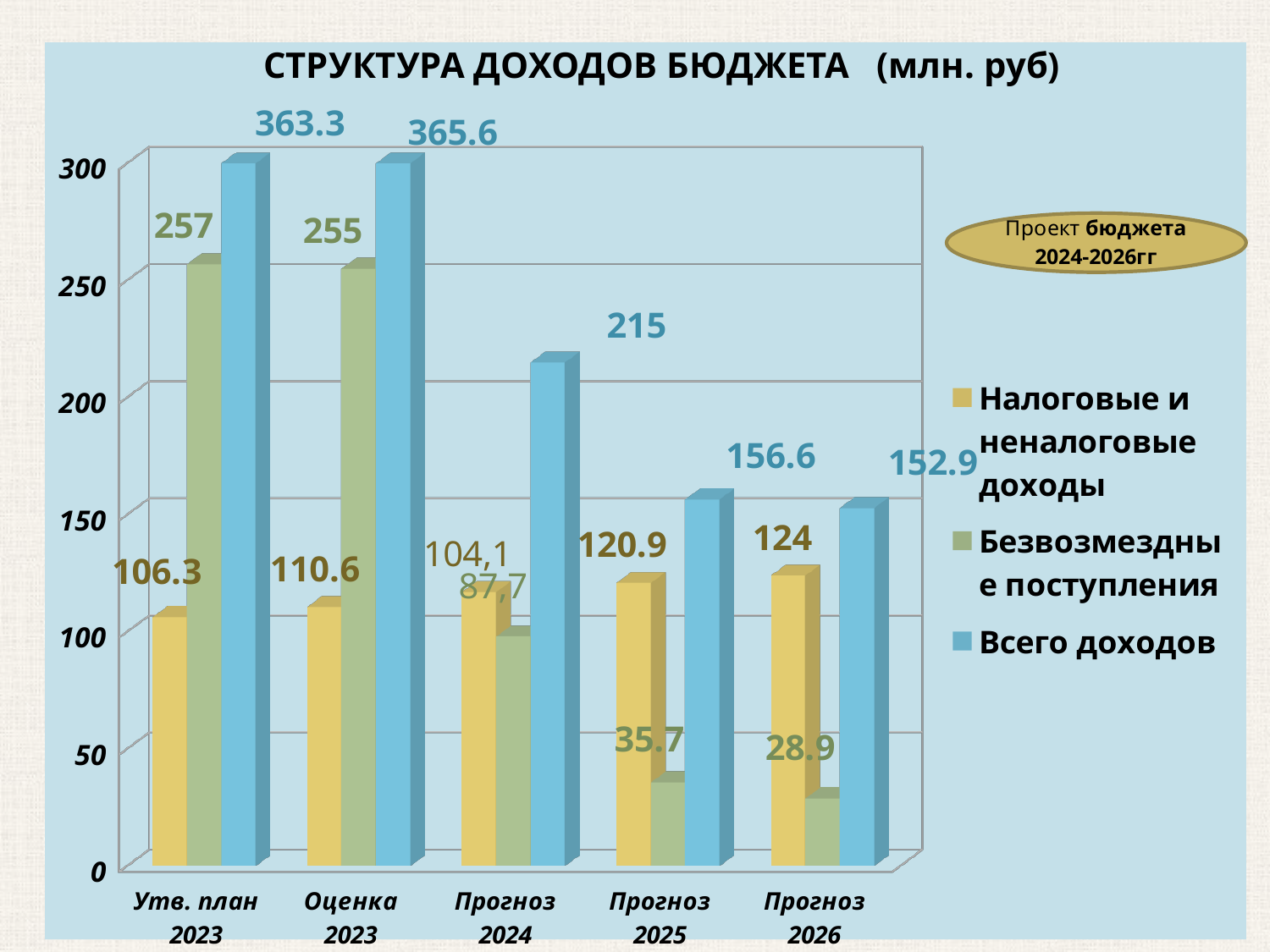
What is the difference between Всего доходов for Прогноз 2024 and Прогноз 2025? 58.4 Does the value of Безвозмездные поступления rise or fall from Прогноз 2024 to Прогноз 2026? Fall What is the value of Всего доходов for Оценка 2023? 365.6 Which category has the highest value of Всего доходов? Оценка 2023 What is the value of Безвозмездные поступления for Прогноз 2025? 35.7 What is the value of Налоговые и неналоговые доходы for Прогноз 2026? 124 How many series does the legend list? 3 What is the value of Безвозмездные поступления for Прогноз 2024? 87,7 What kind of chart is shown on the slide? Bar chart How many categories are shown on the x axis? 5 Which category has the lowest value of Безвозмездные поступления? Прогноз 2026 Which is larger: Налоговые и неналоговые доходы for Утв. план 2023 or for Оценка 2023? Оценка 2023